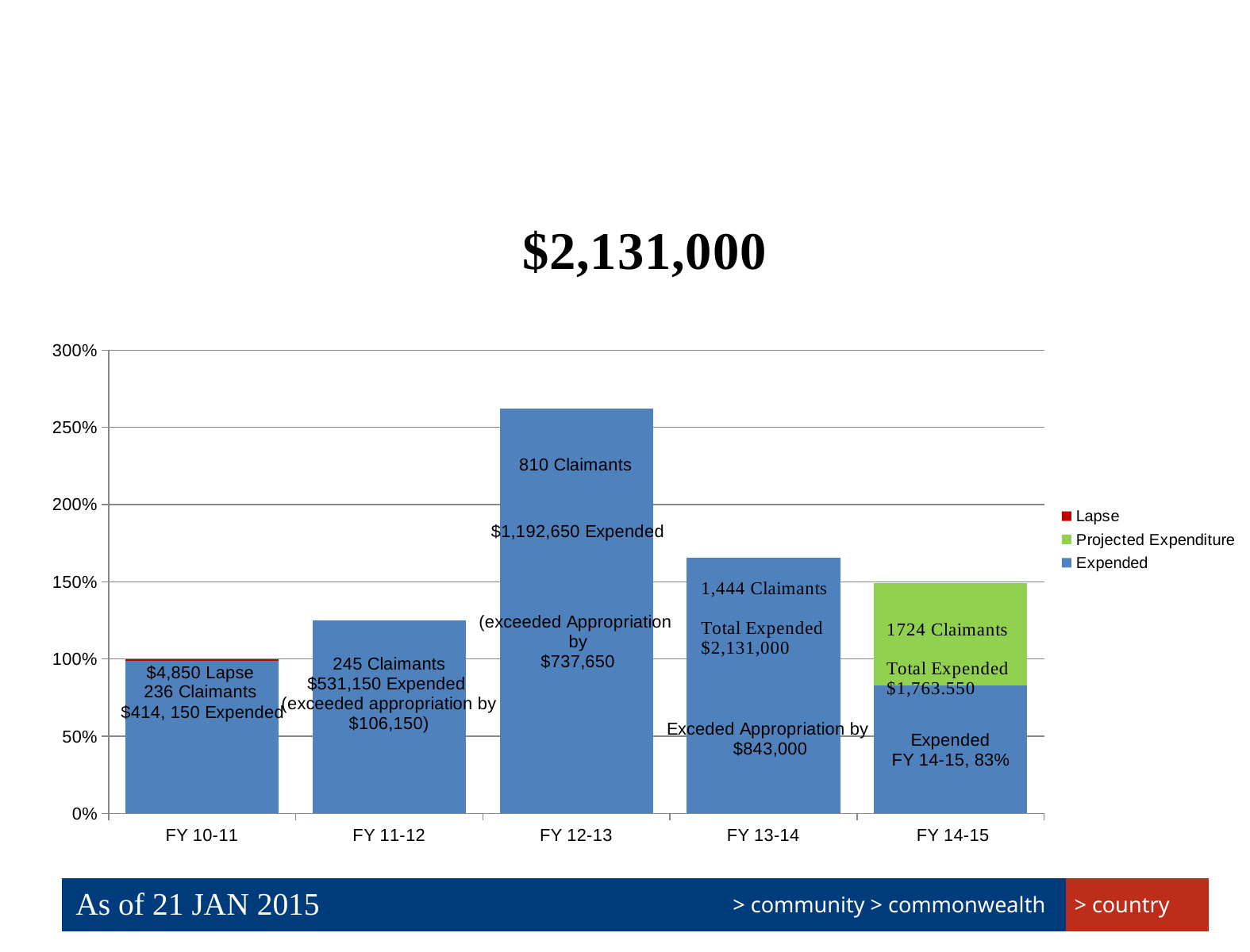
What kind of chart is shown on the slide? bar chart What Lapse amount is labelled on the FY 10-11 bar? $4,850 Which fiscal year has the shortest total bar in the chart? FY 10-11 Is the bar for FY 12-13 greater or less than 250%? greater What is the title shown above the chart? $2,131,000 Which fiscal year has the tallest bar in the chart? FY 12-13 How many claimants are labelled on the FY 12-13 bar? 810 Claimants How many fiscal years are shown on the x axis of the chart? 5 Which bar is taller, FY 12-13 or FY 13-14? FY 12-13 Is the bar for FY 13-14 greater or less than 150%? greater How many series does the chart's legend list? 3 What percentage is labelled as Expended for FY 14-15? 83%